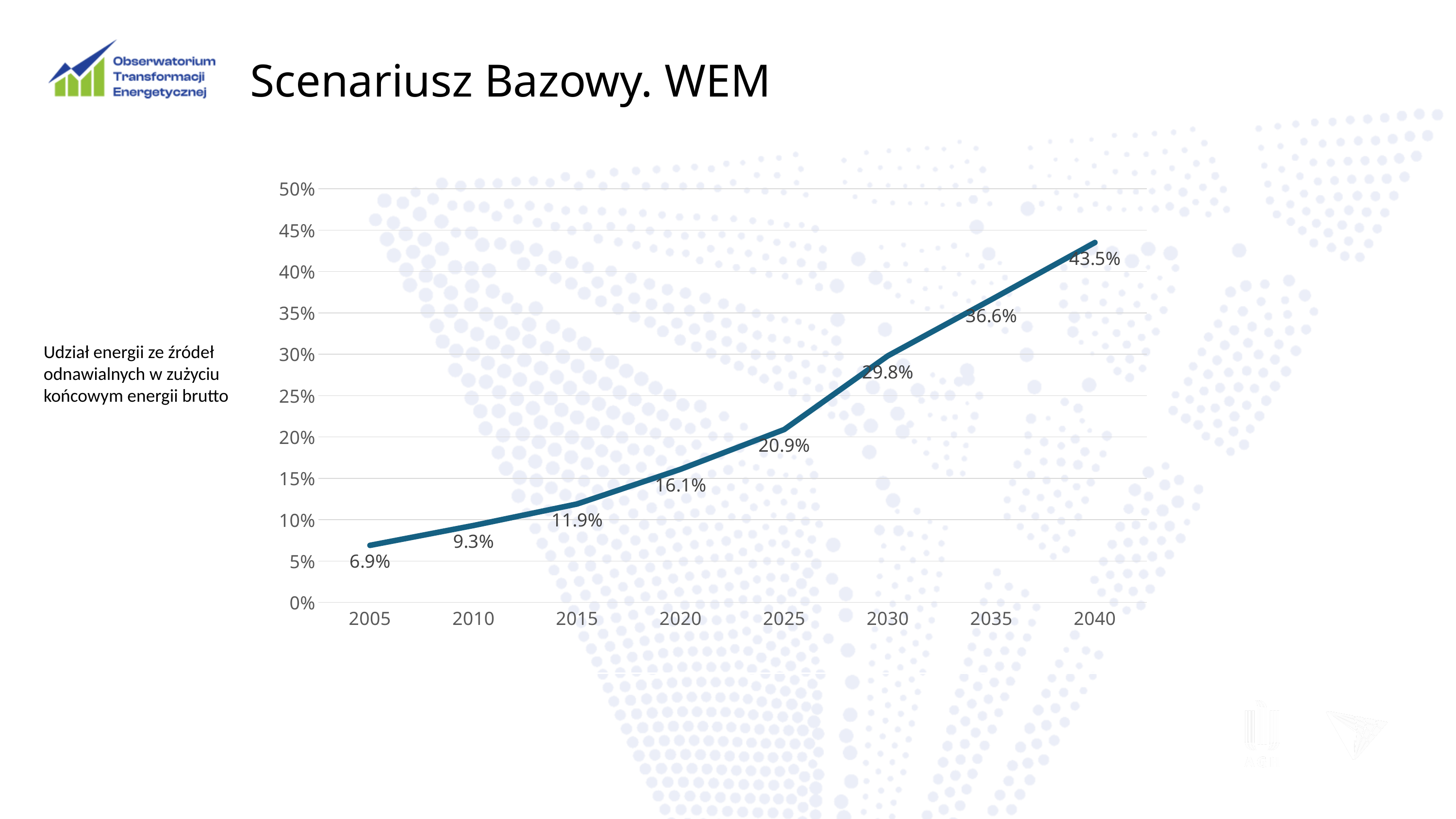
How many data points are plotted on the line? 8 Which year has the lowest value? 2005 What is the value for 2015? 11.9% Is the value for 2030 greater or less than 25%? greater What is the value for 2040? 43.5% What is the difference between the values for 2030 and 2020? 13.7% Do the values rise or fall from 2005 to 2040? rise What kind of chart is shown on the slide? line chart Which is larger, the value for 2035 or the value for 2025? 2035 What is the value for 2005? 6.9% Which year has the highest value? 2040 What is the value for 2025? 20.9%